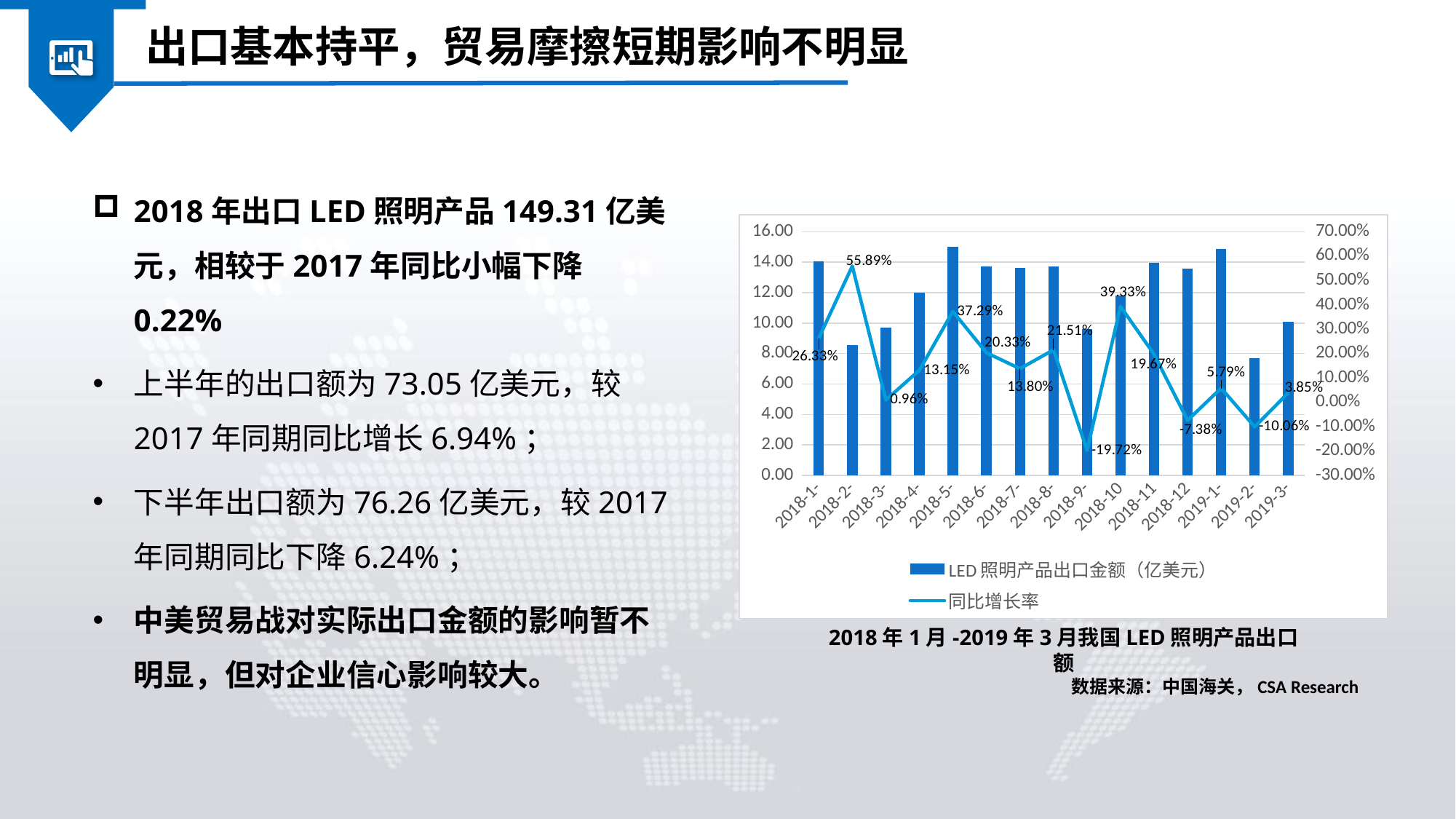
What is the year-on-year growth rate shown for 2018-9? -19.72% What kind of chart is shown on the slide? Combination bar and line chart What is the year-on-year growth rate shown for 2019-3? 3.85% What is the difference between the growth rates for 2018-10 and 2018-11? 19.66% How many series does the legend list? 2 Which month has the lowest year-on-year growth rate on the line? 2018-9 Is the LED export amount bar for 2018-2 greater or less than 10.00? less Which month has the highest year-on-year growth rate on the line? 2018-2 How many months are plotted on the x axis? 15 Is the LED export amount bar for 2019-1 greater or less than 14.00? greater Which has the higher year-on-year growth rate, 2018-5 or 2018-6? 2018-5 What is the year-on-year growth rate (同比增长率) shown for 2018-2? 55.89%